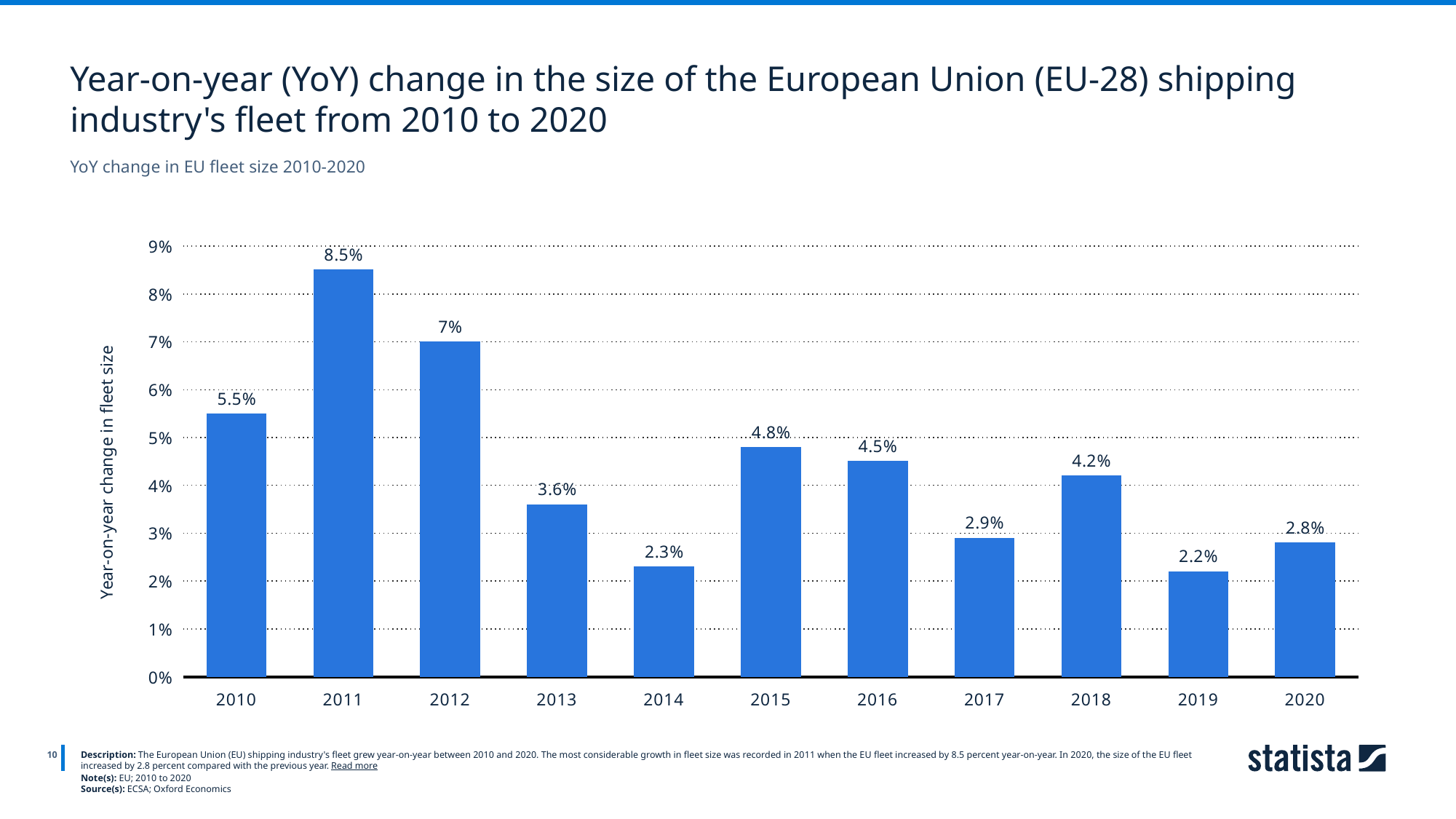
What is the difference between the year-on-year change in 2011 and in 2012? 1.5% Is the value for 2013 greater or less than 4%? less Did the year-on-year change in fleet size rise or fall from 2018 to 2019? Fall What is the label of the vertical axis? Year-on-year change in fleet size What was the year-on-year change in EU fleet size in 2014? 2.3% What was the year-on-year change in EU fleet size in 2011? 8.5% How many years are shown on the chart? 11 Which year had the highest year-on-year change in fleet size? 2011 Which year had the lowest year-on-year change in fleet size? 2019 What was the year-on-year change in EU fleet size in 2020? 2.8% Which year had a larger year-on-year change in fleet size, 2015 or 2016? 2015 What kind of chart is shown on the slide? Bar chart